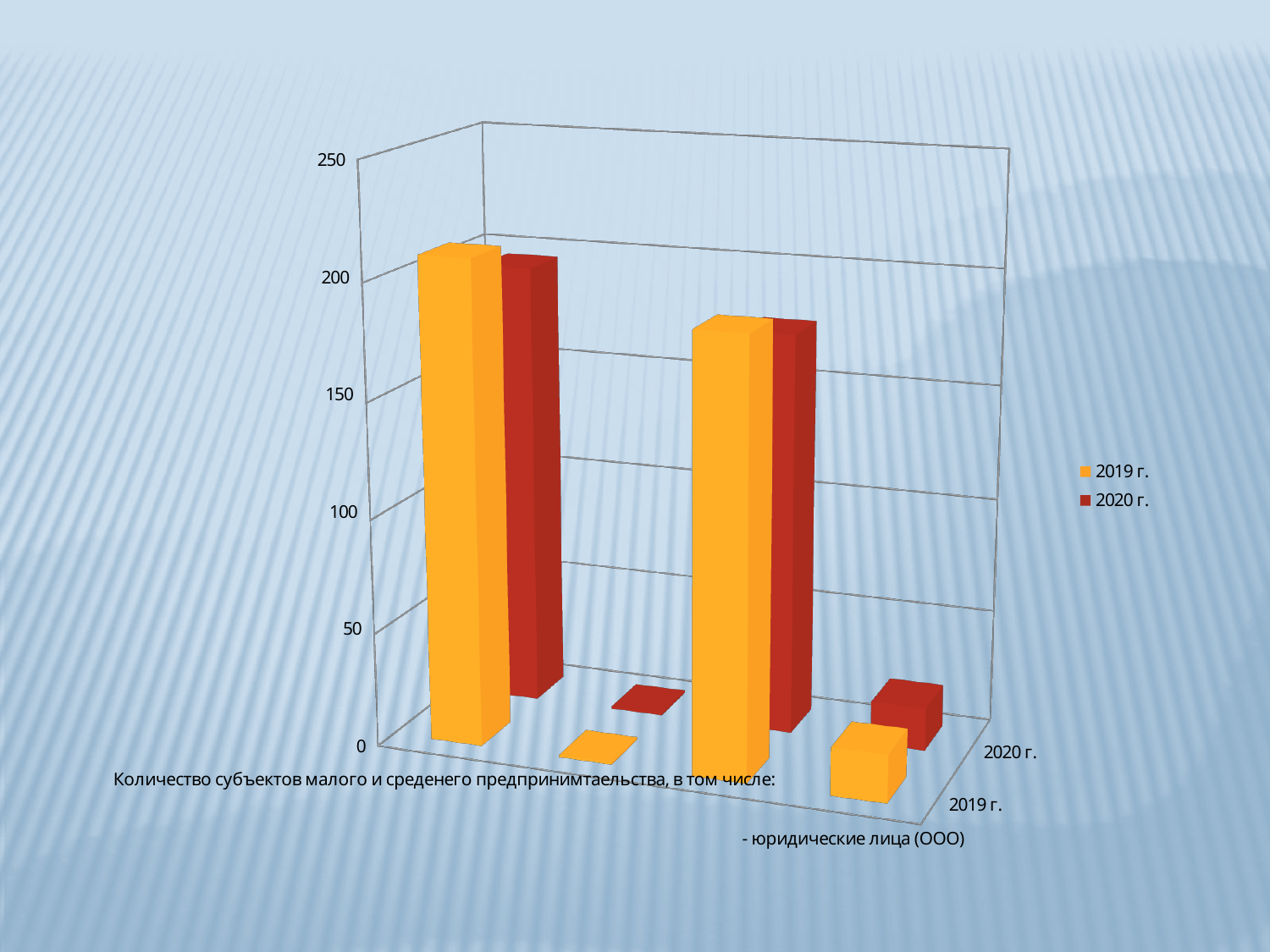
Which is larger: the 2019 г. bar in the leftmost group or the 2019 г. bar in the third group from the left? the leftmost group Is the value of the 2019 г. bar in the leftmost group greater or less than 150? greater What are the two entries in the chart legend? 2019 г. and 2020 г. What is the highest value shown on the vertical axis? 250 Is the value of the 2019 г. bar in the third group from the left greater or less than 200? less How many series does the legend list? 2 Is the value of the 2019 г. bar in the third group from the left greater or less than 150? greater How many groups of bars are plotted along the category axis? 4 What kind of chart is shown on the slide? bar chart